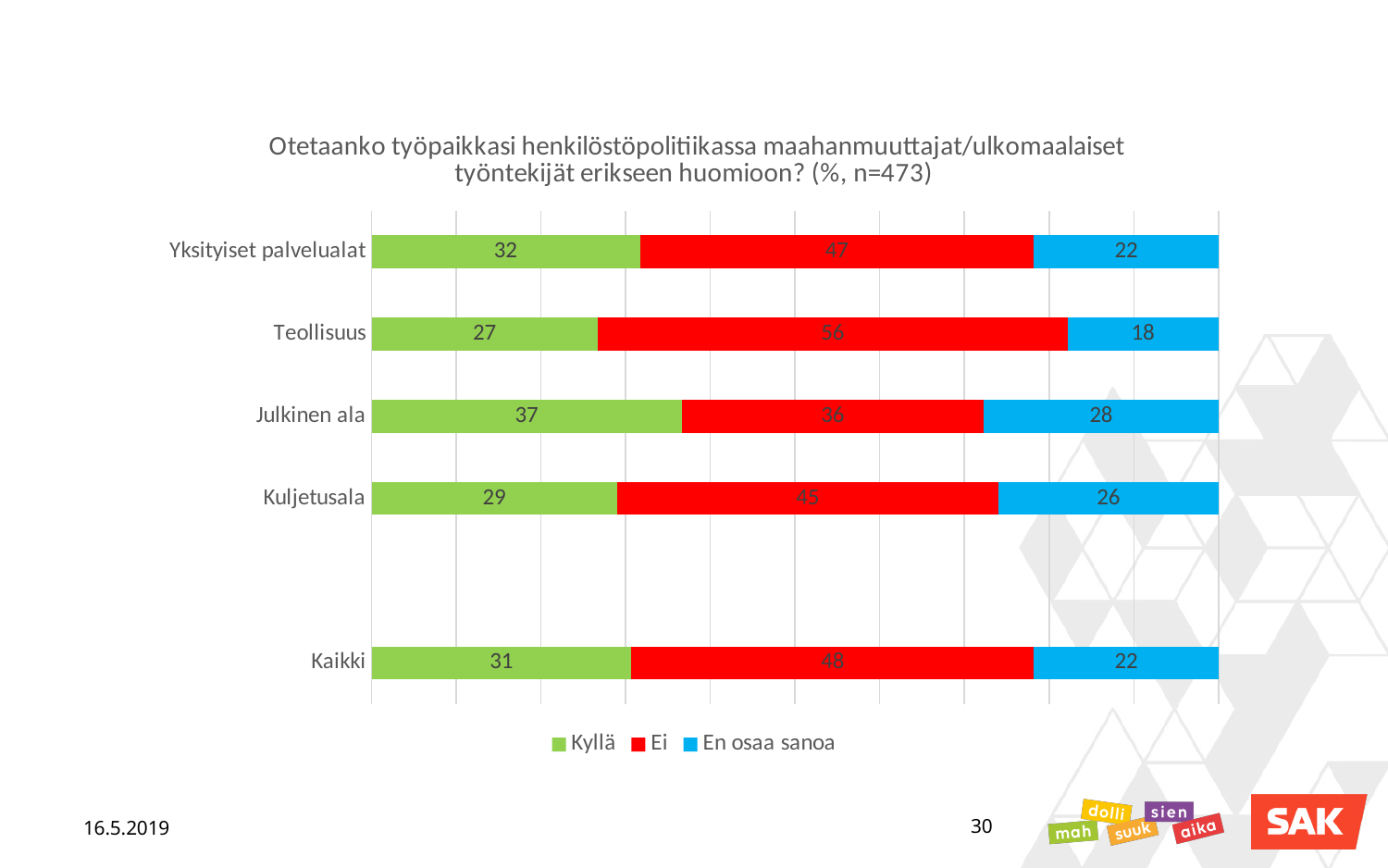
What is the "Kyllä" value for Julkinen ala? 37 Which is larger: the "Kyllä" value for Yksityiset palvelualat or for Kuljetusala? Yksityiset palvelualat How many categories are shown on the chart? 5 What is the "En osaa sanoa" value for Kuljetusala? 26 Which colour represents the "En osaa sanoa" series? Blue What kind of chart is shown on the slide? Stacked bar chart Which category has the highest "Ei" value? Teollisuus What is the difference between the "Ei" values for Teollisuus and Julkinen ala? 20 What is the "Ei" value for Teollisuus? 56 How many series does the legend list? 3 What is the total of the stacked bar for Kaikki? 101 Which category has the lowest "Kyllä" value? Teollisuus